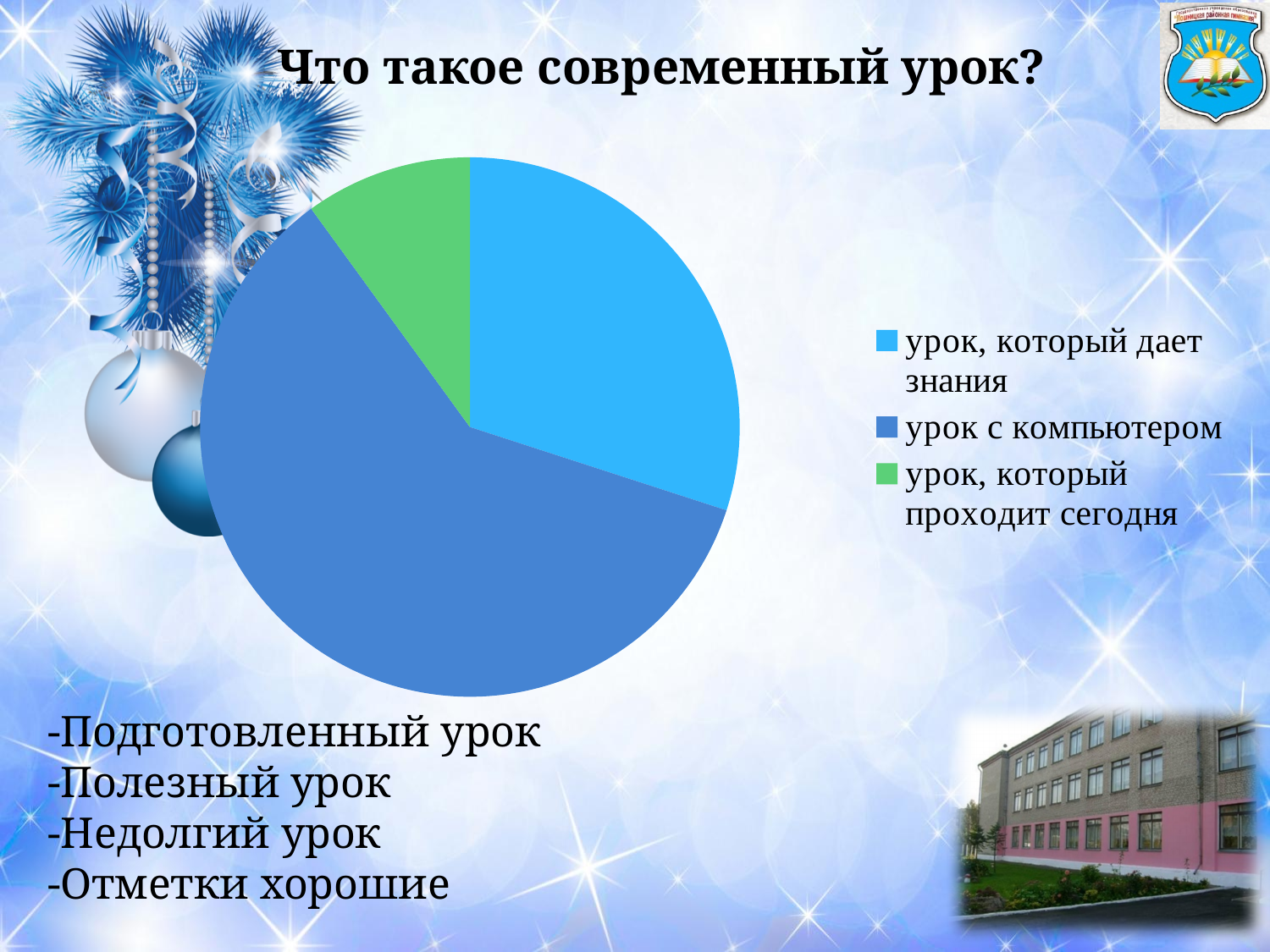
What kind of chart is shown on the slide? pie chart What is the title of the slide containing the pie chart? Что такое современный урок? Which category has the smallest slice of the pie chart? урок, который проходит сегодня Which slice is larger: "урок с компьютером" or "урок, который дает знания"? урок с компьютером What colour is the slice for "урок, который проходит сегодня" in the pie chart? green Which slice is larger: "урок, который дает знания" or "урок, который проходит сегодня"? урок, который дает знания How many entries does the legend of the pie chart list? 3 Which category has the largest slice of the pie chart? урок с компьютером How many slices does the pie chart have? 3 Which slice is smaller: "урок с компьютером" or "урок, который проходит сегодня"? урок, который проходит сегодня